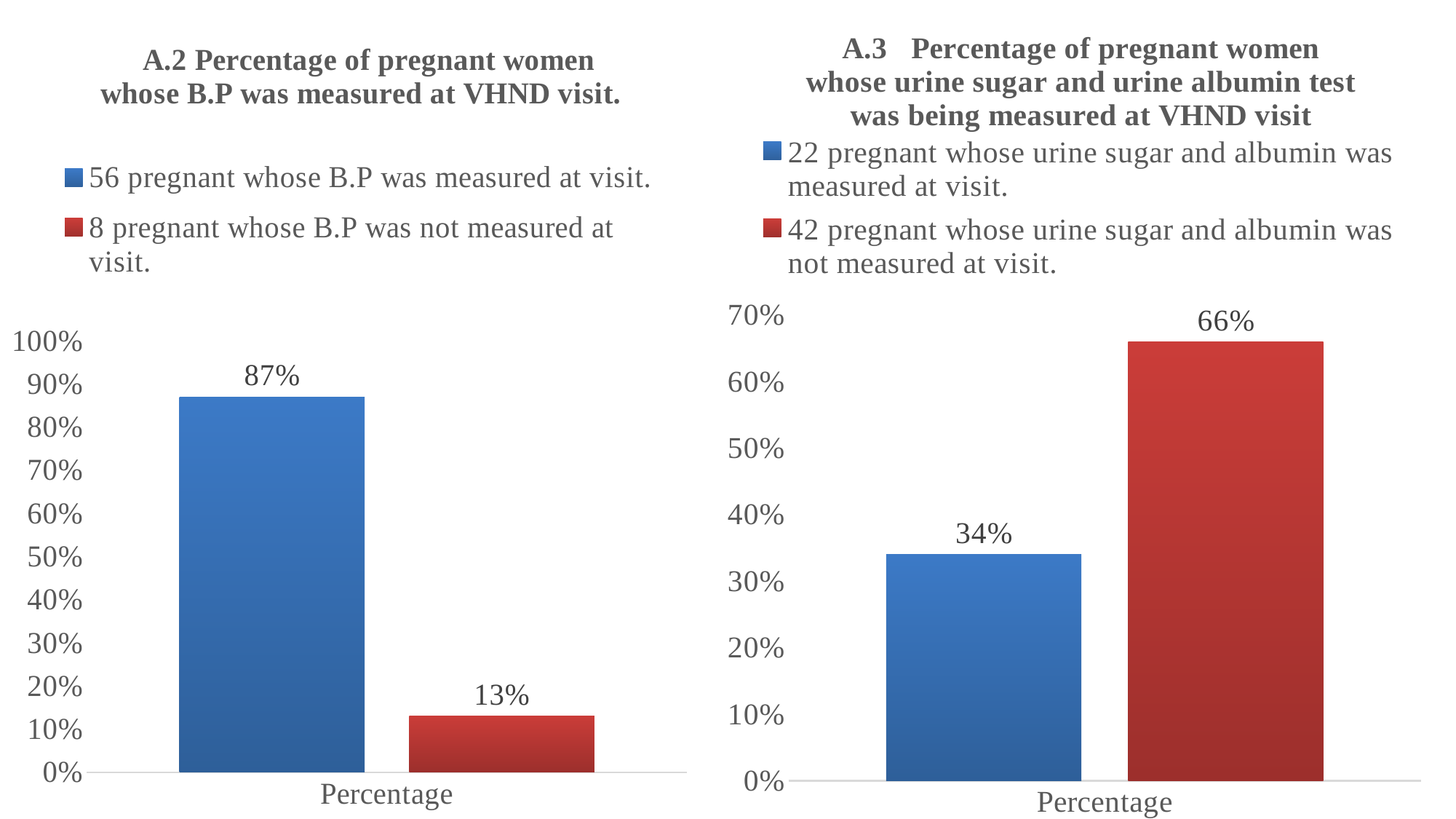
How many series does the legend of the A.3 chart (right) list? 2 Is the blue bar in the A.3 chart (right) larger or smaller than the blue bar in the A.2 chart (left)? smaller In the A.3 chart (right), what percentage of pregnant women did not have their urine sugar and albumin measured at the visit? 66% In the A.2 chart (left), which series has the higher value? 56 pregnant whose B.P was measured at visit. In the A.2 chart (left), what percentage of pregnant women had their B.P measured at the VHND visit? 87% In the A.2 chart (left), what percentage of pregnant women did not have their B.P measured at the visit? 13% In the A.3 chart (right), what is the difference between the not measured and measured percentages? 32% What type of chart is the A.2 chart (left)? bar chart In the A.3 chart (right), what percentage of pregnant women had their urine sugar and albumin measured at the visit? 34% In the A.3 chart (right), which series has the lower value? 22 pregnant whose urine sugar and albumin was measured at visit. In the A.2 chart (left), what is the difference between the measured and not measured percentages? 74% What is the x-axis category label shown under the bars in the A.3 chart (right)? Percentage